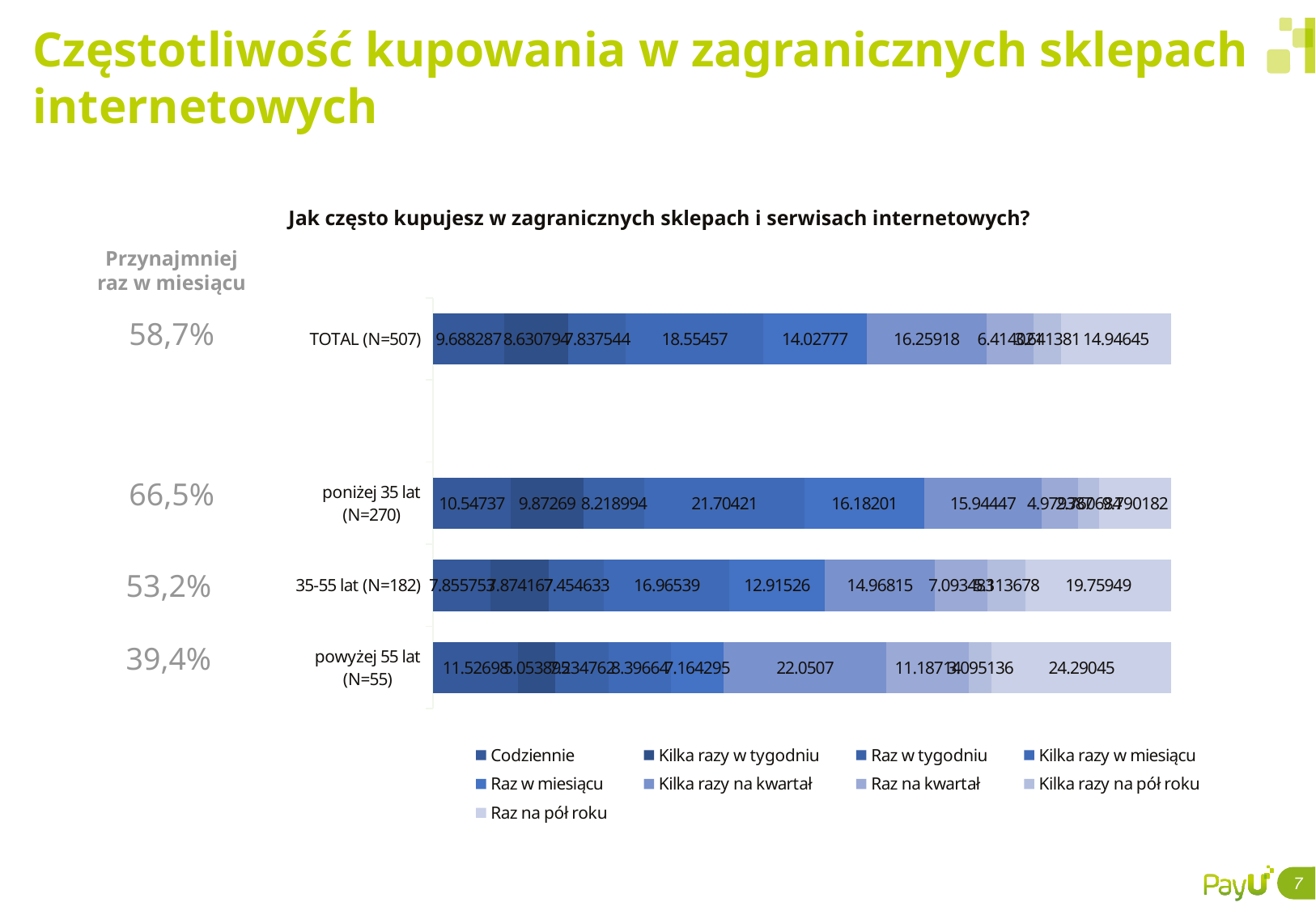
What is the value of 'Raz na pół roku' for powyżej 55 lat (N=55)? 24.29045 What is the value of 'Raz w miesiącu' for poniżej 35 lat (N=270)? 16.18201 Which age group has the highest value for 'Kilka razy w miesiącu'? poniżej 35 lat (N=270) What is the value of 'Kilka razy w miesiącu' for TOTAL (N=507)? 18.55457 How many categories (bars) are plotted in the chart? 4 What kind of chart is shown on the slide? stacked bar chart What is the 'Przynajmniej raz w miesiącu' percentage shown for powyżej 55 lat (N=55)? 39,4% How many series does the chart legend list? 9 What is the value of 'Codziennie' for poniżej 35 lat (N=270)? 10.54737 What is the value of 'Kilka razy na kwartał' for 35-55 lat (N=182)? 14.96815 What is the title of the chart? Jak często kupujesz w zagranicznych sklepach i serwisach internetowych? Which is larger: 'Raz na pół roku' for 35-55 lat (N=182) or for powyżej 55 lat (N=55)? powyżej 55 lat (N=55)